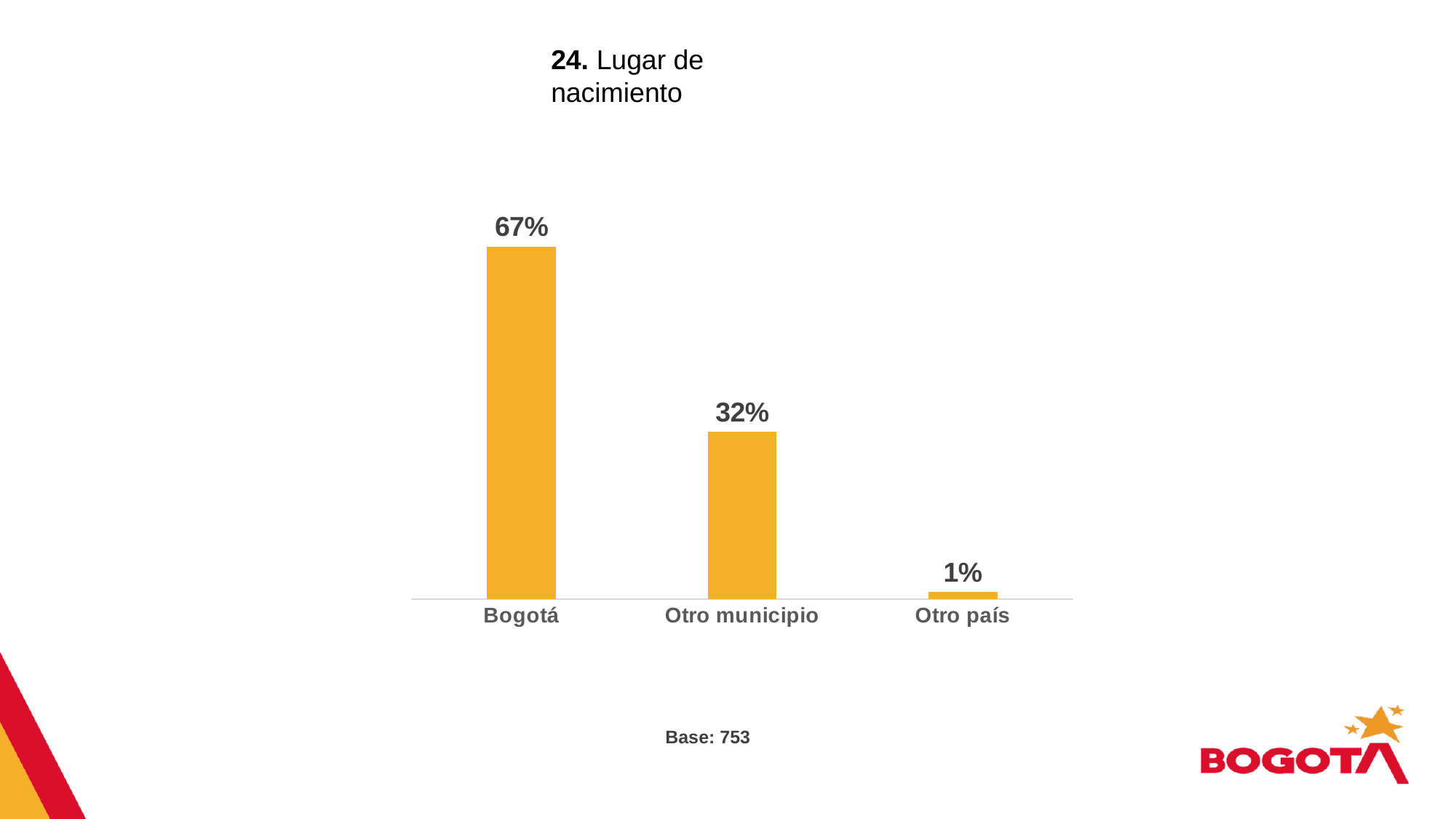
Which category has the lowest value? Otro país Which category has the highest value? Bogotá Do the values rise or fall from left to right across the categories? Fall What is the title of the chart? 24. Lugar de nacimiento How many categories are shown in the chart? 3 What is the value for Bogotá? 67% What is the difference between the values for Bogotá and Otro municipio? 35% What kind of chart is shown on the slide? Bar chart What is the value for Otro país? 1% Which is larger, the value for Otro municipio or the value for Otro país? Otro municipio What is the value for Otro municipio? 32% What is the difference between the values for Otro municipio and Otro país? 31%